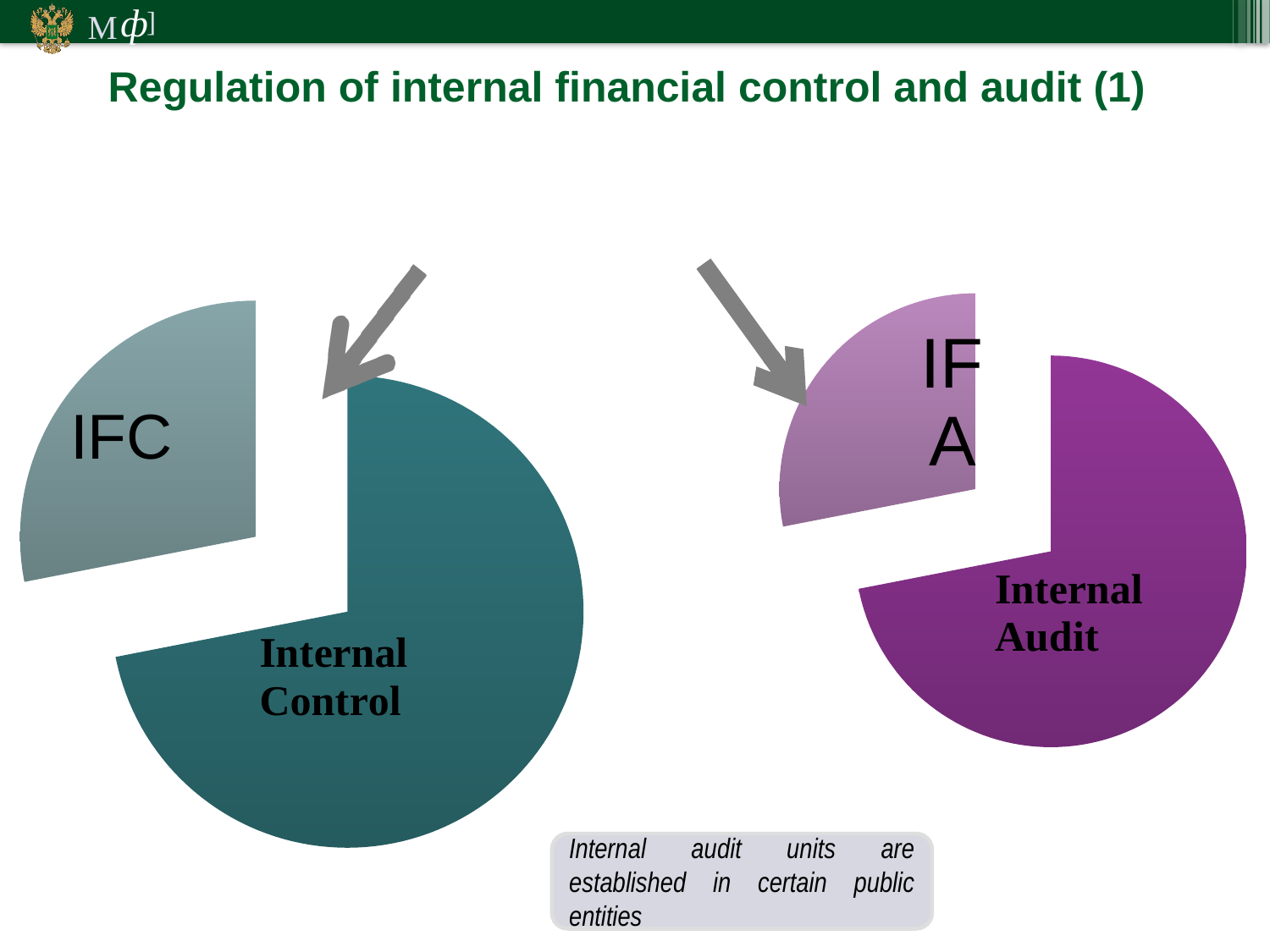
What kind of chart is the left chart on the slide? pie chart What is the title of the slide containing the two pie charts? Regulation of internal financial control and audit (1) In the left pie chart, which slice is the largest? Internal Control What kind of chart is the right chart on the slide? pie chart How many slices does the right pie chart have? 2 In the right pie chart, which slice is larger, IFA or Internal Audit? Internal Audit In the left pie chart, which slice is the smallest? IFC How many pie charts are shown on the slide? 2 In the right pie chart, which slice is the smallest? IFA How many slices does the left pie chart have? 2 In the left pie chart, which slice is larger, IFC or Internal Control? Internal Control In the right pie chart, which slice is the largest? Internal Audit